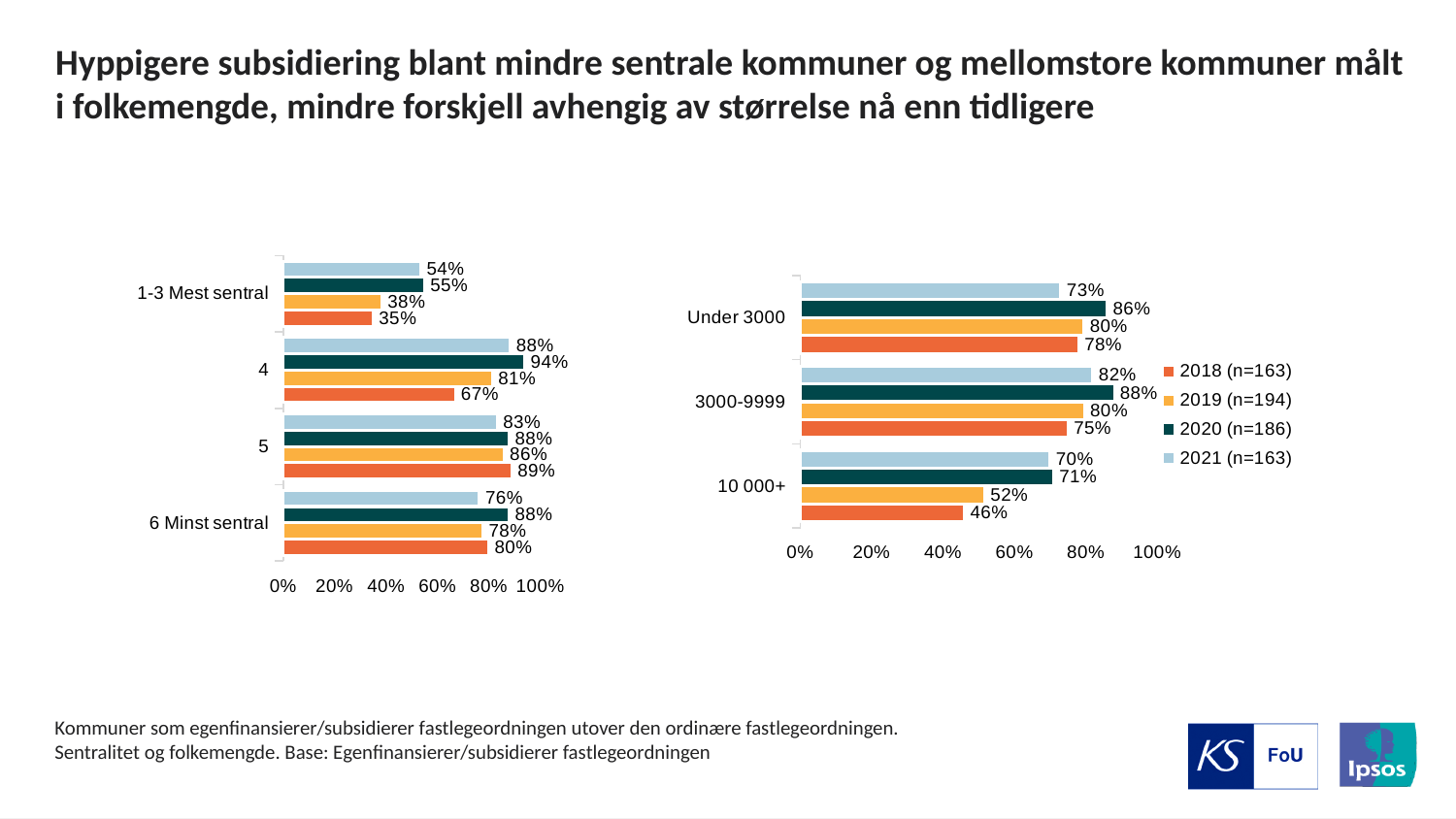
In the right chart (by population size), which is larger for '3000-9999': the 2021 value or the 2018 value? 2021 In the right chart (by population size), which category has the lowest 2018 value? 10 000+ In the right chart (by population size), what is the 2020 value for 'Under 3000'? 86% In the left chart (by centrality), what is the 2021 value for '1-3 Mest sentral'? 54% In the right chart (by population size), what is the 2019 value for '10 000+'? 52% How many series does the legend list? 4 What type of chart is the left chart (by centrality)? Bar chart In the left chart (by centrality), what is the difference between the 2020 and 2018 values for '1-3 Mest sentral'? 20 percentage points In the left chart (by centrality), which category has the highest 2020 value? 4 In the right chart (by population size), what is the difference between the 2021 and 2018 values for '10 000+'? 24 percentage points In the left chart (by centrality), what is the 2018 value for category '4'? 67% How many categories are shown in the right chart (by population size)? 3